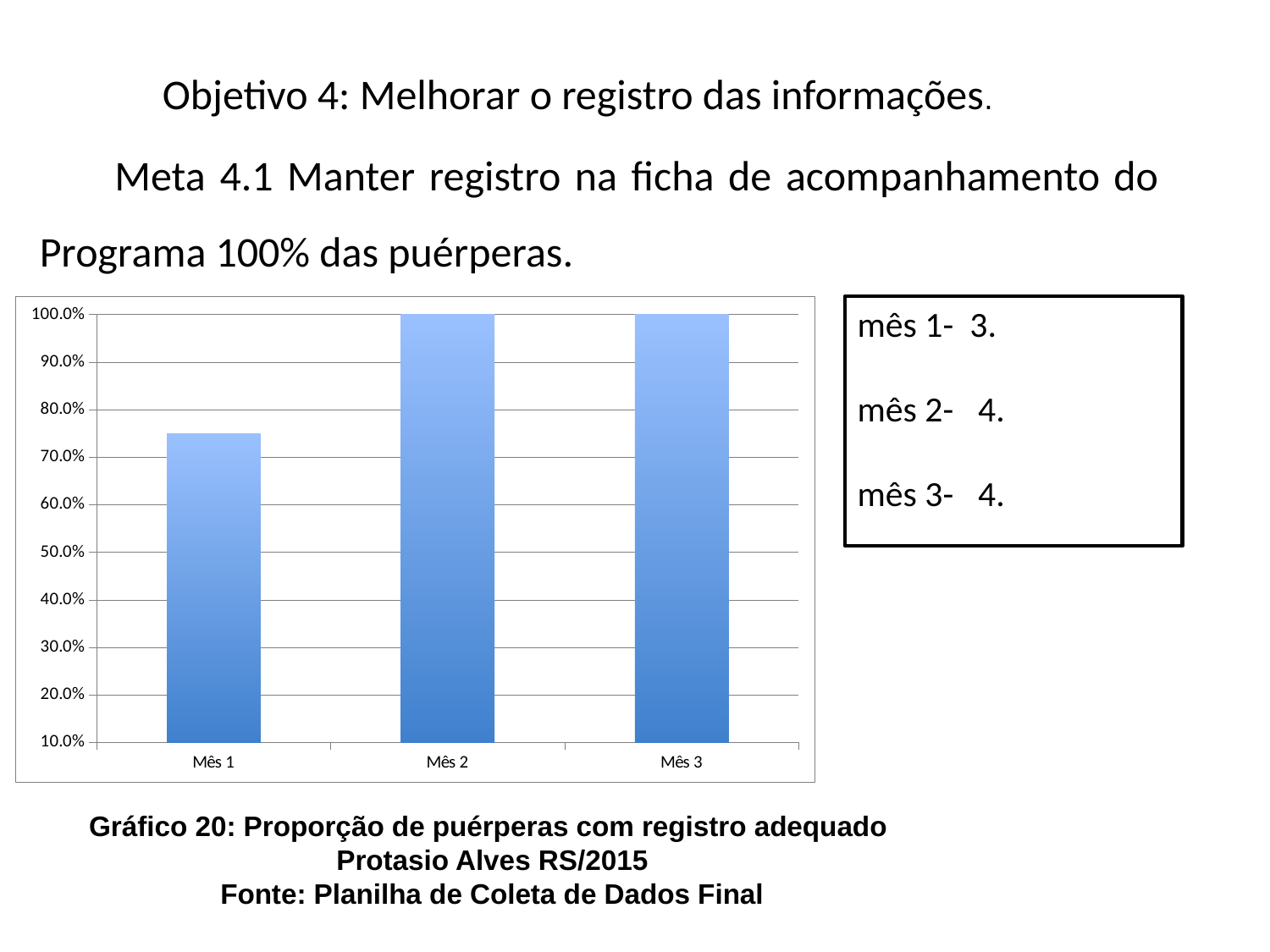
Which is larger, the value for Mês 1 or the value for Mês 2? Mês 2 Which month has the lowest value on the chart? Mês 1 Is the value for Mês 1 greater or less than 70.0%? greater Is the value for Mês 1 greater or less than 80.0%? less What is the difference between the values for Mês 2 and Mês 3? 0.0% How many categories (months) are plotted on the chart? 3 What is the value for Mês 2? 100.0% What type of chart is shown on the slide? bar chart What is the lowest value shown on the vertical axis of the chart? 10.0% What is the value for Mês 3? 100.0% What is the title given in the caption below the chart (Gráfico 20)? Proporção de puérperas com registro adequado Do the values rise or fall from Mês 1 to Mês 2? rise